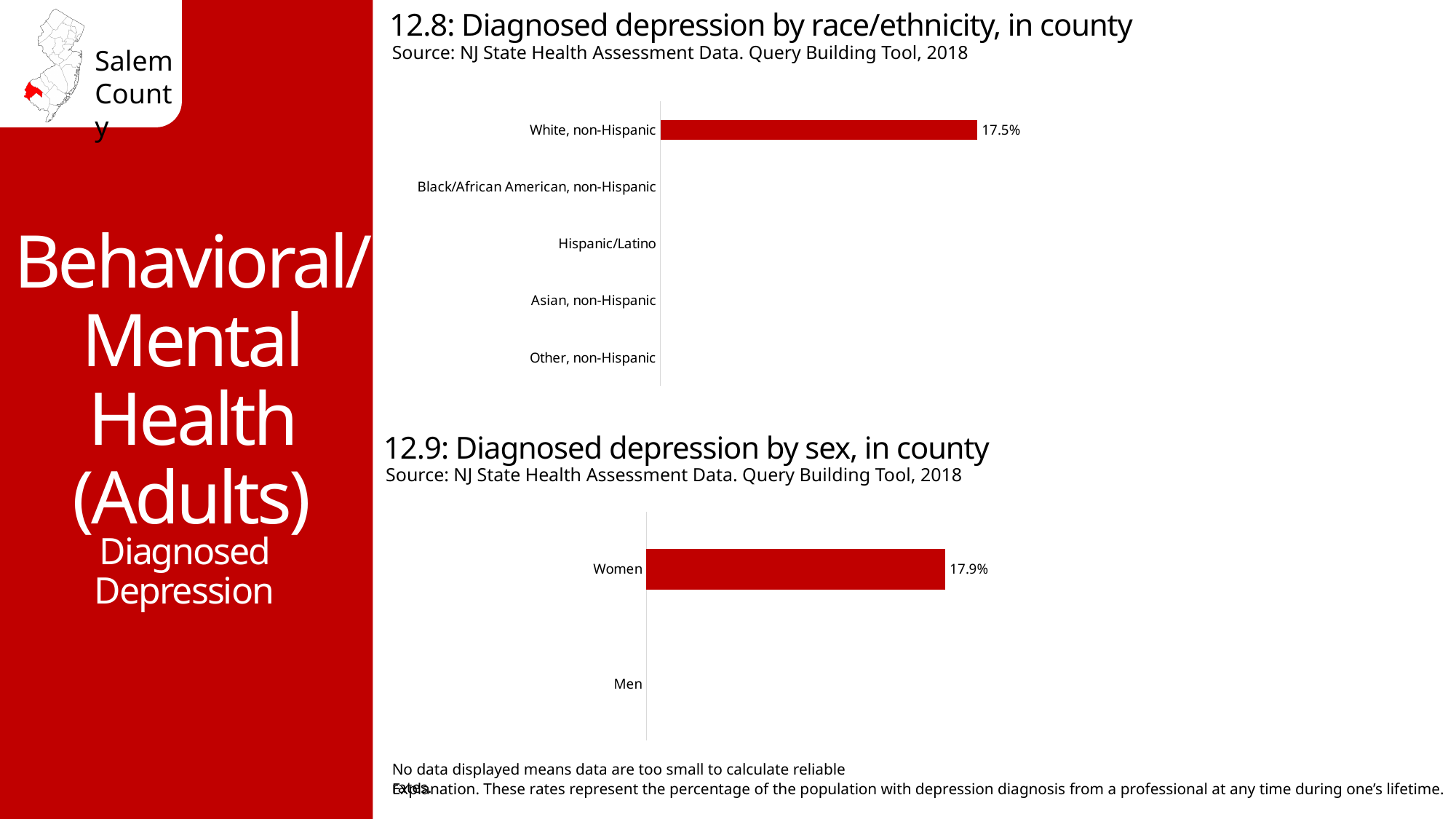
In the chart '12.9: Diagnosed depression by sex, in county', what is the value for Women? 17.9% How many race/ethnicity categories are listed on the axis of the chart '12.8: Diagnosed depression by race/ethnicity, in county'? 5 Which is larger: the value for Women in chart 12.9 or the value for White, non-Hispanic in chart 12.8? Women In the chart '12.8: Diagnosed depression by race/ethnicity, in county', what is the value for White, non-Hispanic? 17.5% In the chart '12.8: Diagnosed depression by race/ethnicity, in county', which category has the highest value shown? White, non-Hispanic In the chart '12.9: Diagnosed depression by sex, in county', which category has a bar displayed? Women What kind of chart is '12.8: Diagnosed depression by race/ethnicity, in county'? Bar chart What is the difference between the value for Women in chart 12.9 and the value for White, non-Hispanic in chart 12.8? 0.4% What is the source cited under the chart '12.9: Diagnosed depression by sex, in county'? NJ State Health Assessment Data. Query Building Tool, 2018 What kind of chart is '12.9: Diagnosed depression by sex, in county'? Bar chart How many categories are listed on the axis of the chart '12.9: Diagnosed depression by sex, in county'? 2 In the chart '12.8: Diagnosed depression by race/ethnicity, in county', how many categories have a bar displayed? 1